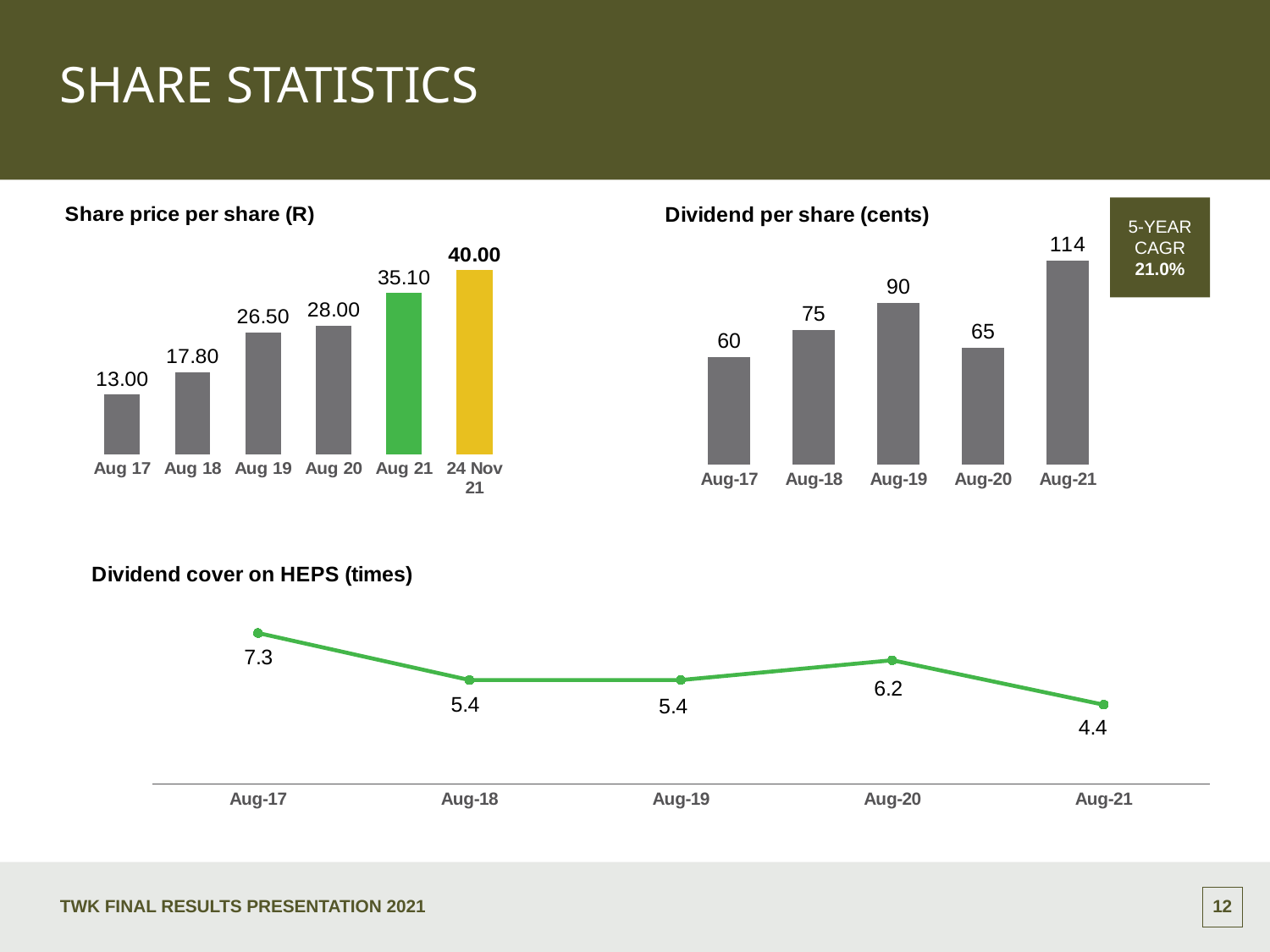
In the 'Dividend per share (cents)' chart, which period has the lowest value? Aug-17 In the 'Dividend cover on HEPS (times)' chart, which period has the lowest value? Aug-21 In the 'Share price per share (R)' chart, do the values rise or fall from Aug 17 to 24 Nov 21? rise In the 'Share price per share (R)' chart, how many bars are plotted? 6 What kind of chart is 'Dividend cover on HEPS (times)'? line chart In the 'Share price per share (R)' chart, what is the value for 24 Nov 21? 40.00 In the 'Dividend per share (cents)' chart, what is the value for Aug-20? 65 In the 'Dividend per share (cents)' chart, which period has the highest value? Aug-21 In the 'Share price per share (R)' chart, what is the value for Aug 19? 26.50 In the 'Dividend per share (cents)' chart, what is the difference between the Aug-21 and Aug-20 values? 49 In the 'Share price per share (R)' chart, what is the difference between the Aug 21 and Aug 20 values? 7.10 In the 'Dividend per share (cents)' chart, what 5-year CAGR is shown? 21.0%